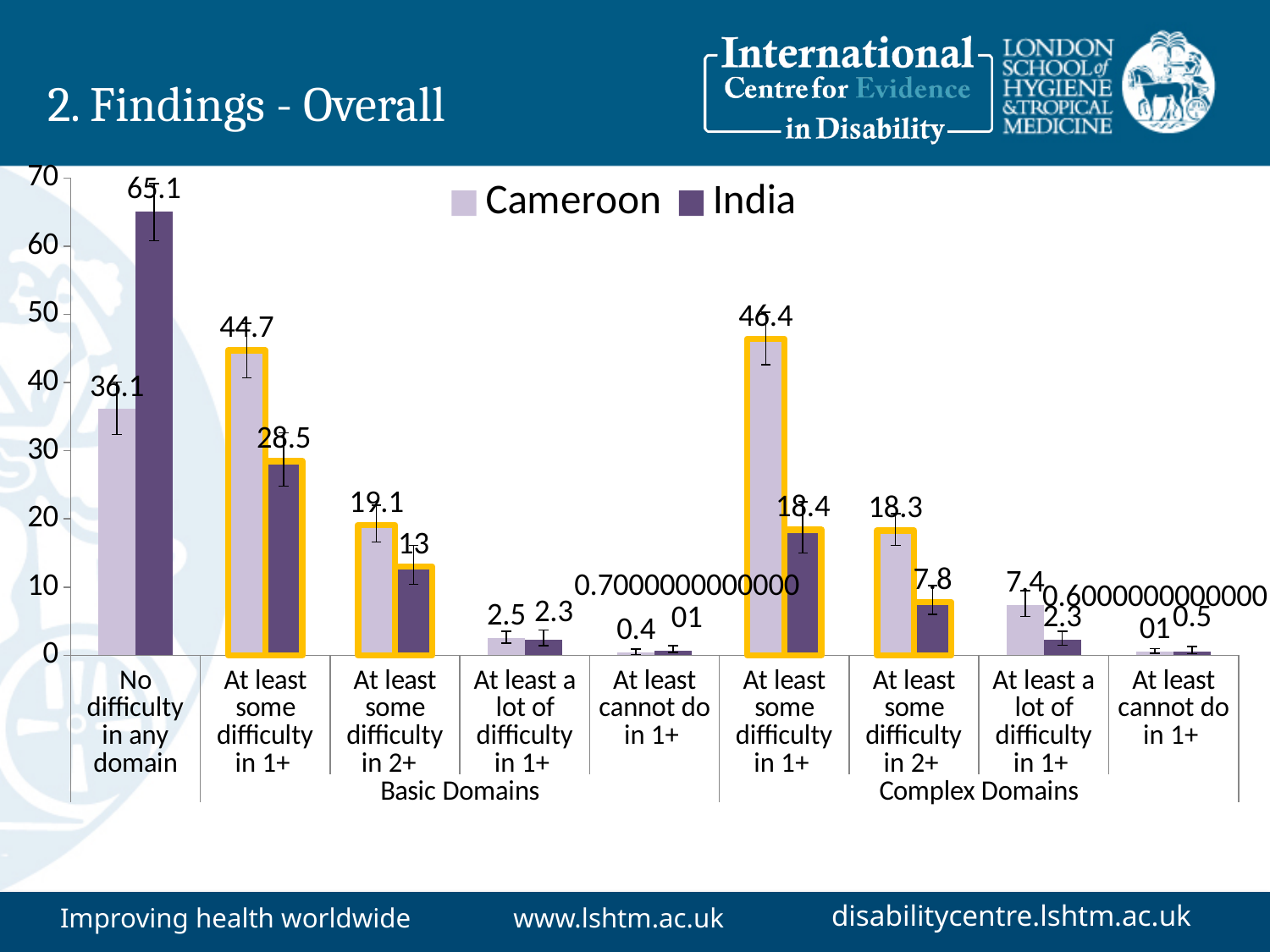
What is the difference between the India and Cameroon values for 'No difficulty in any domain'? 29 Which category has the highest Cameroon value? At least some difficulty in 1+ (Complex Domains) How many series does the legend list? 2 What is the difference between the Cameroon and India values for 'At least some difficulty in 1+' in the Basic Domains? 16.2 What is the value for Cameroon for 'At least some difficulty in 1+' in the Complex Domains? 46.4 What kind of chart is shown on the slide? Bar chart What is the value for India for 'No difficulty in any domain'? 65.1 Which category has the highest India value? No difficulty in any domain What is the value for Cameroon for 'At least some difficulty in 1+' in the Basic Domains? 44.7 Which series has the higher value for 'At least some difficulty in 2+' in the Basic Domains, Cameroon or India? Cameroon Which series has the higher value for 'No difficulty in any domain', Cameroon or India? India What is the value for India for 'At least some difficulty in 2+' in the Complex Domains? 7.8